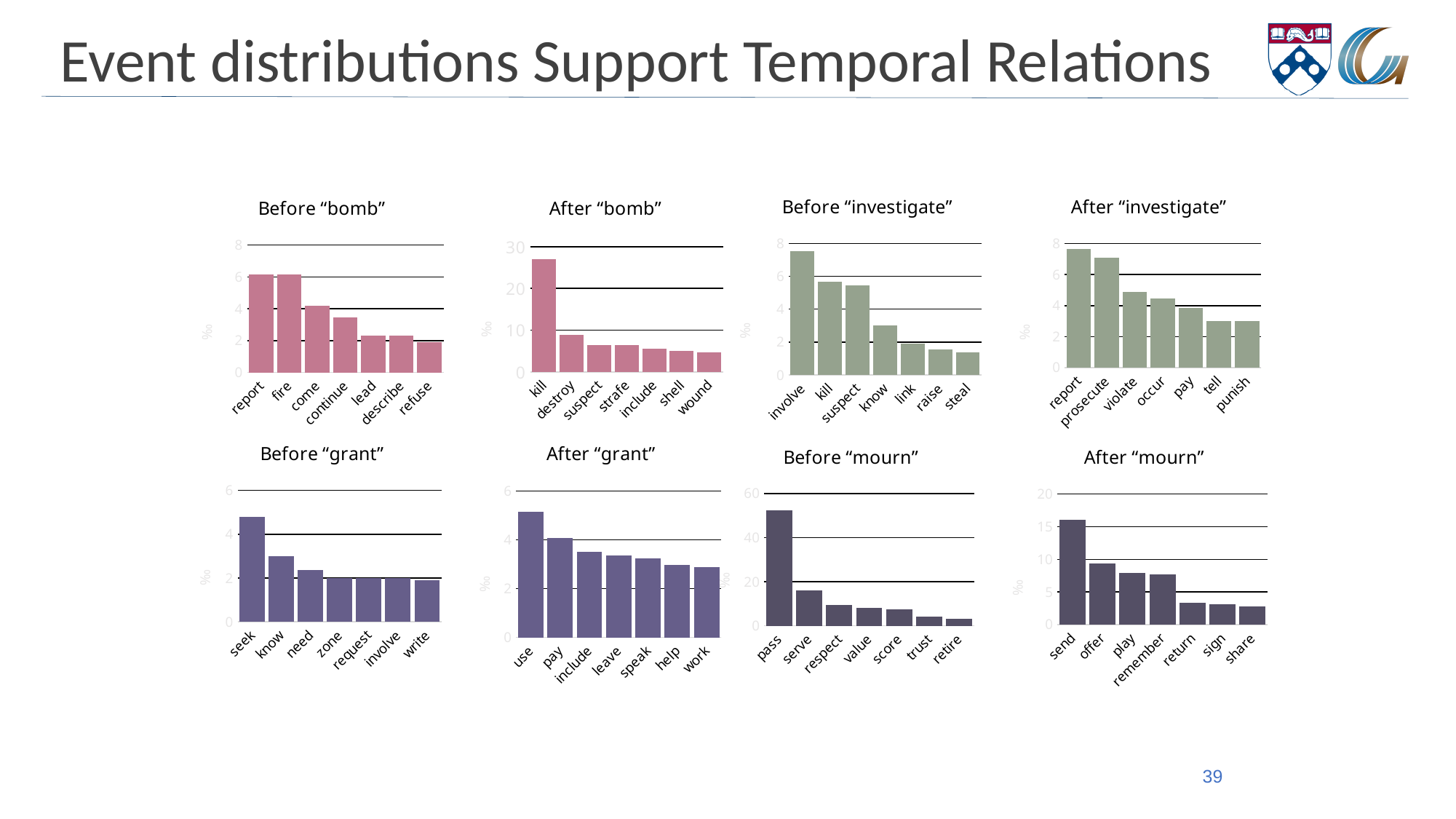
In the Before "grant" chart, is the value for seek greater or less than 4? greater In the Before "mourn" chart, is the value for serve greater or less than 20? less How many categories are shown in the Before "bomb" chart? 7 In the Before "investigate" chart, is the value for know greater or less than 4? less In the After "investigate" chart, do the values rise or fall from left to right? fall In the After "bomb" chart, which category has the highest value? kill What kind of chart is the Before "grant" chart? bar chart In the After "mourn" chart, which category has the highest value? send In the After "grant" chart, which is larger, the value for use or the value for work? use In the Before "mourn" chart, which category has the highest value? pass